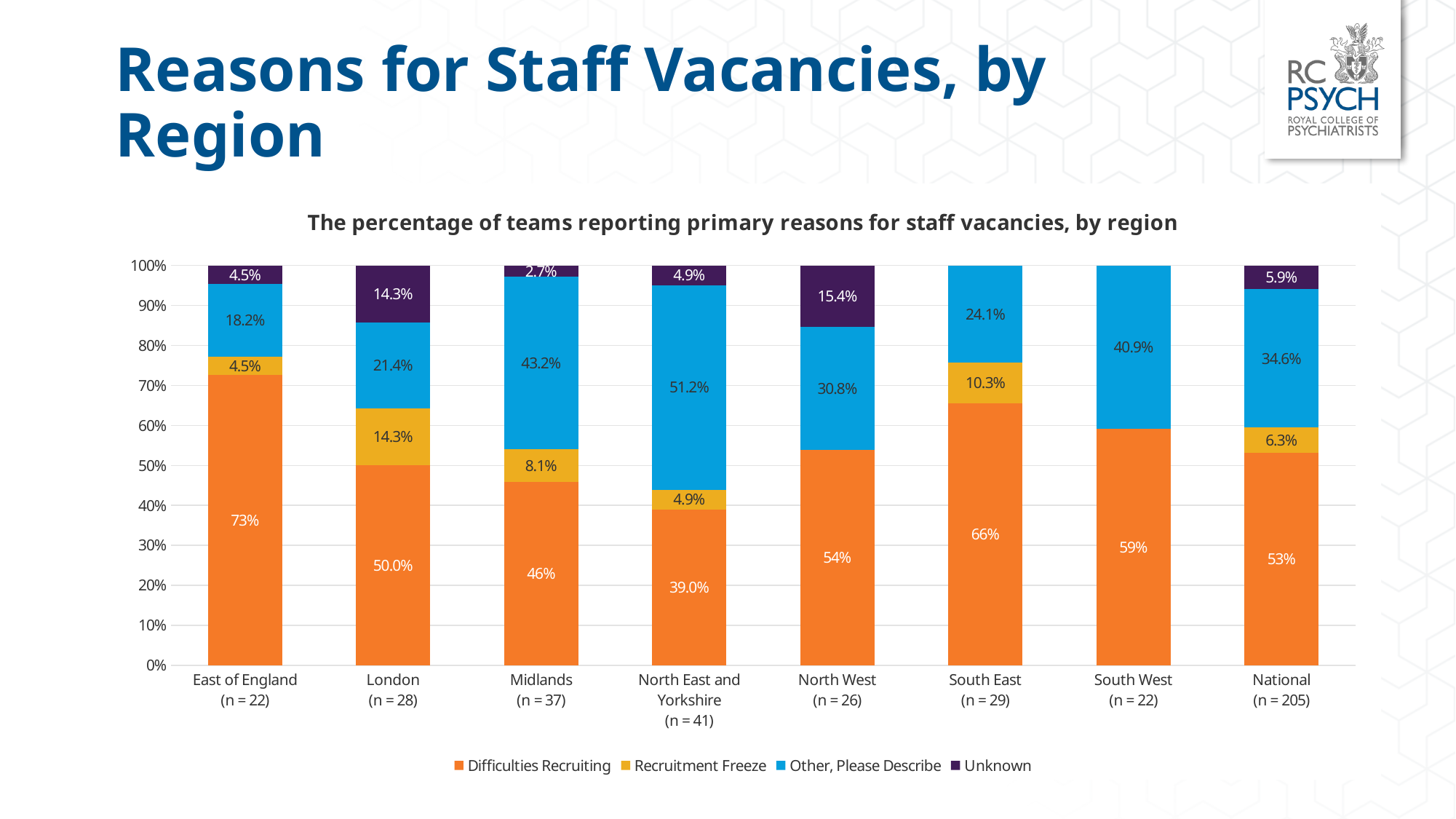
What is the sample size (n) shown for the National category? 205 How many regions (categories) are shown on the x axis? 8 Which region has the lowest percentage for Difficulties Recruiting? North East and Yorkshire What percentage of teams in London reported a Recruitment Freeze? 14.3% What is the value for Other, Please Describe in North East and Yorkshire? 51.2% How many series does the legend list? 4 Which region has the highest percentage for Difficulties Recruiting? East of England Which is larger: the Other, Please Describe value for the South West or for the South East? South West What is the Unknown value for the North West? 15.4% What percentage of teams in the East of England reported Difficulties Recruiting as the primary reason for staff vacancies? 73% What kind of chart is shown on the slide? Stacked bar chart What is the difference between the Recruitment Freeze percentage in London and in the Midlands? 6.2 percentage points